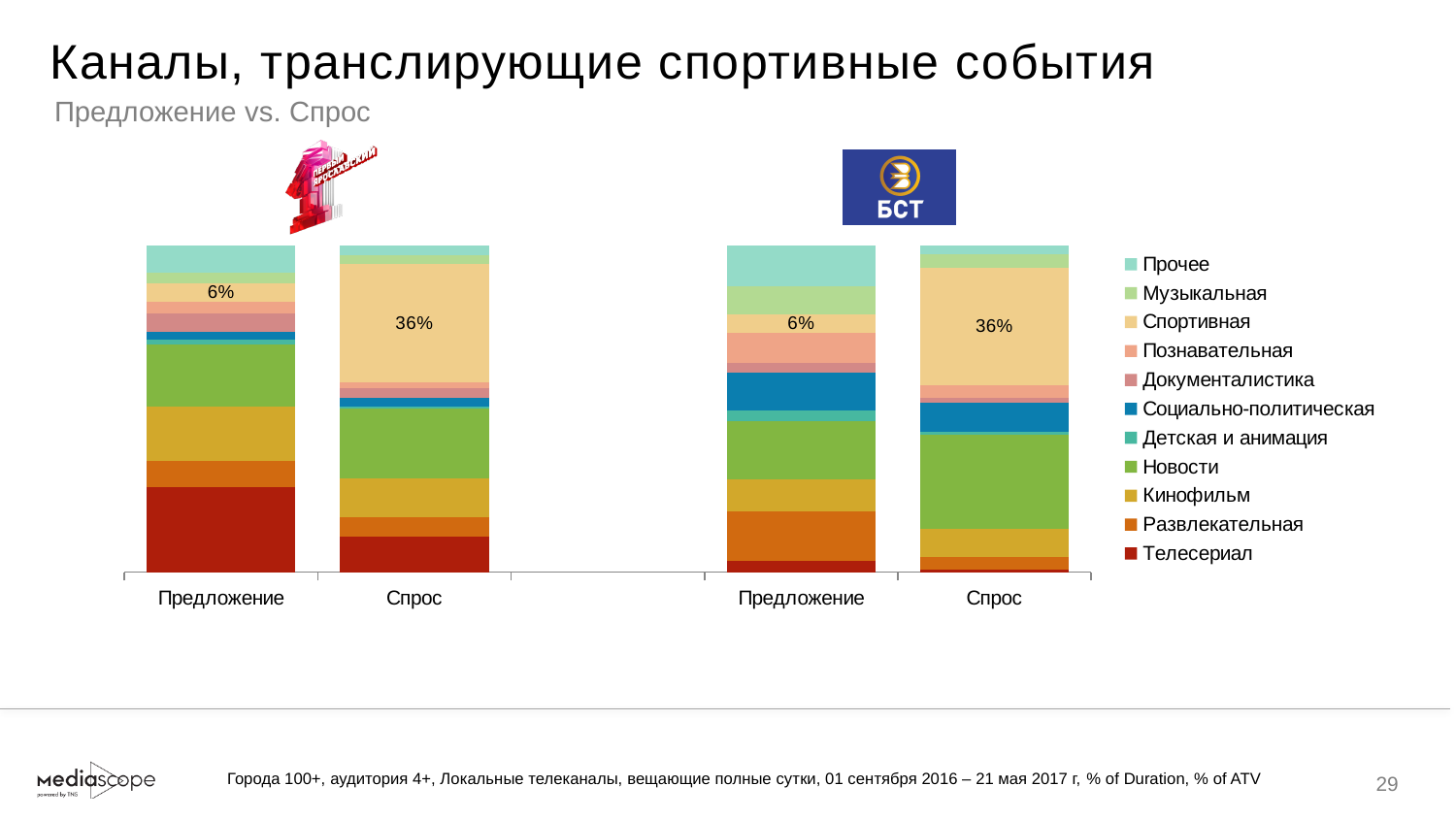
In the right chart, what is the value of the Спортивная segment in the Предложение bar? 6% How many bars does the left chart contain? 2 How many series does the legend list? 11 In the right chart, which bar has the larger Спортивная segment, Предложение or Спрос? Спрос What kind of chart is used on this slide? Stacked bar chart In the right chart, which bar has the larger Новости segment, Предложение or Спрос? Спрос In the left chart, by how many percentage points does the Спортивная share in Спрос exceed that in Предложение? 30 percentage points Which series is listed last in the legend? Телесериал In the left chart, what is the value of the Спортивная segment in the Предложение bar? 6% In the left chart, which bar has the larger Телесериал segment, Предложение or Спрос? Предложение In the right chart, what is the value of the Спортивная segment in the Спрос bar? 36% In the left chart, what is the value of the Спортивная segment in the Спрос bar? 36%